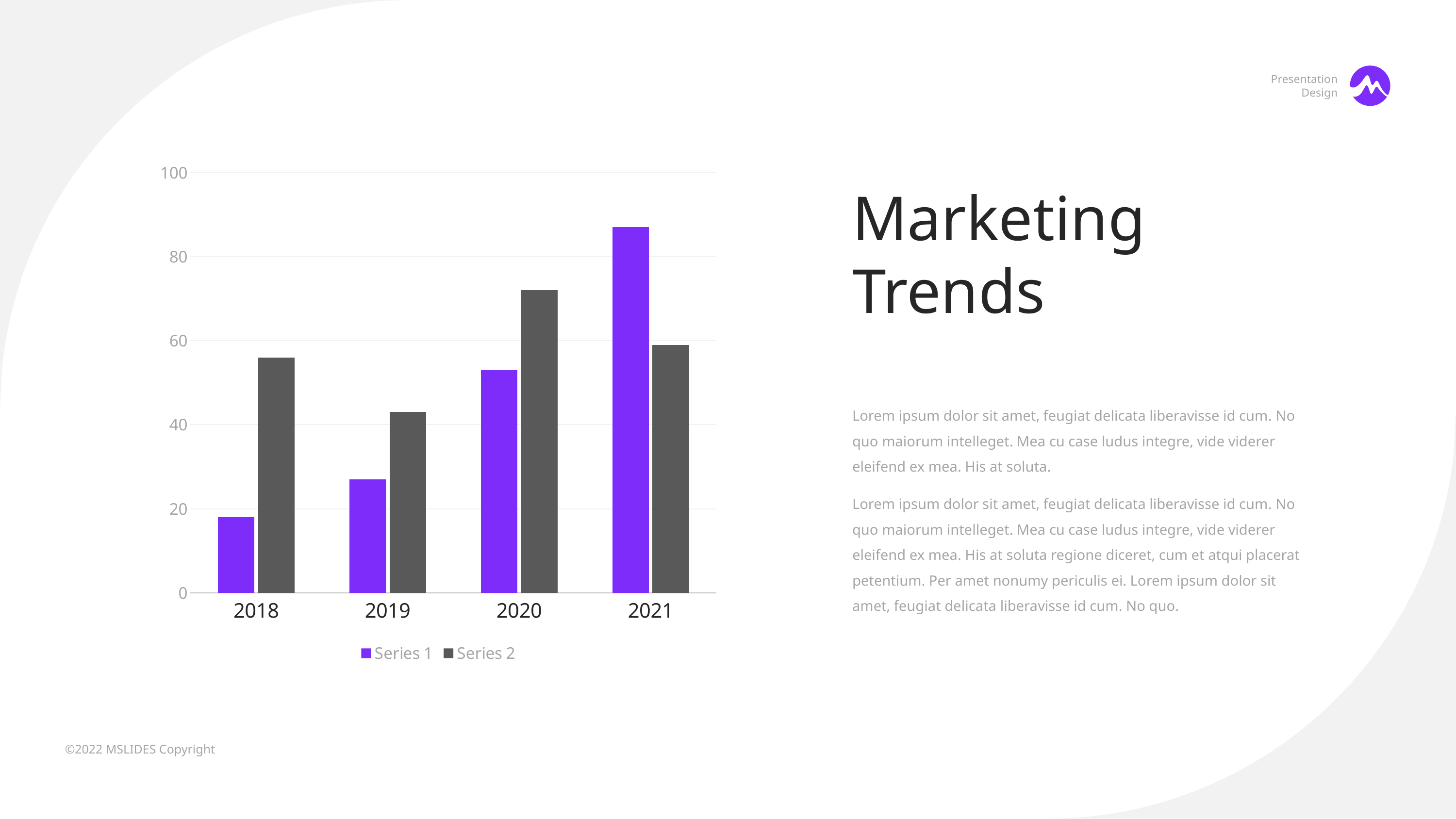
In 2021, which series has the larger value, Series 1 or Series 2? Series 1 Do the Series 1 values rise or fall from 2018 to 2021? rise Is the value for Series 1 in 2021 greater or less than 80? greater In 2018, which series has the larger value, Series 1 or Series 2? Series 2 What kind of chart is shown on the slide? bar chart How many years are shown on the x axis of the chart? 4 In which year is the Series 1 bar the lowest? 2018 In which year is the Series 1 bar the highest? 2021 In which year is the Series 2 bar the lowest? 2019 How many series does the chart's legend list? 2 What colour are the Series 1 bars in the chart? purple In which year is the Series 2 bar the highest? 2020